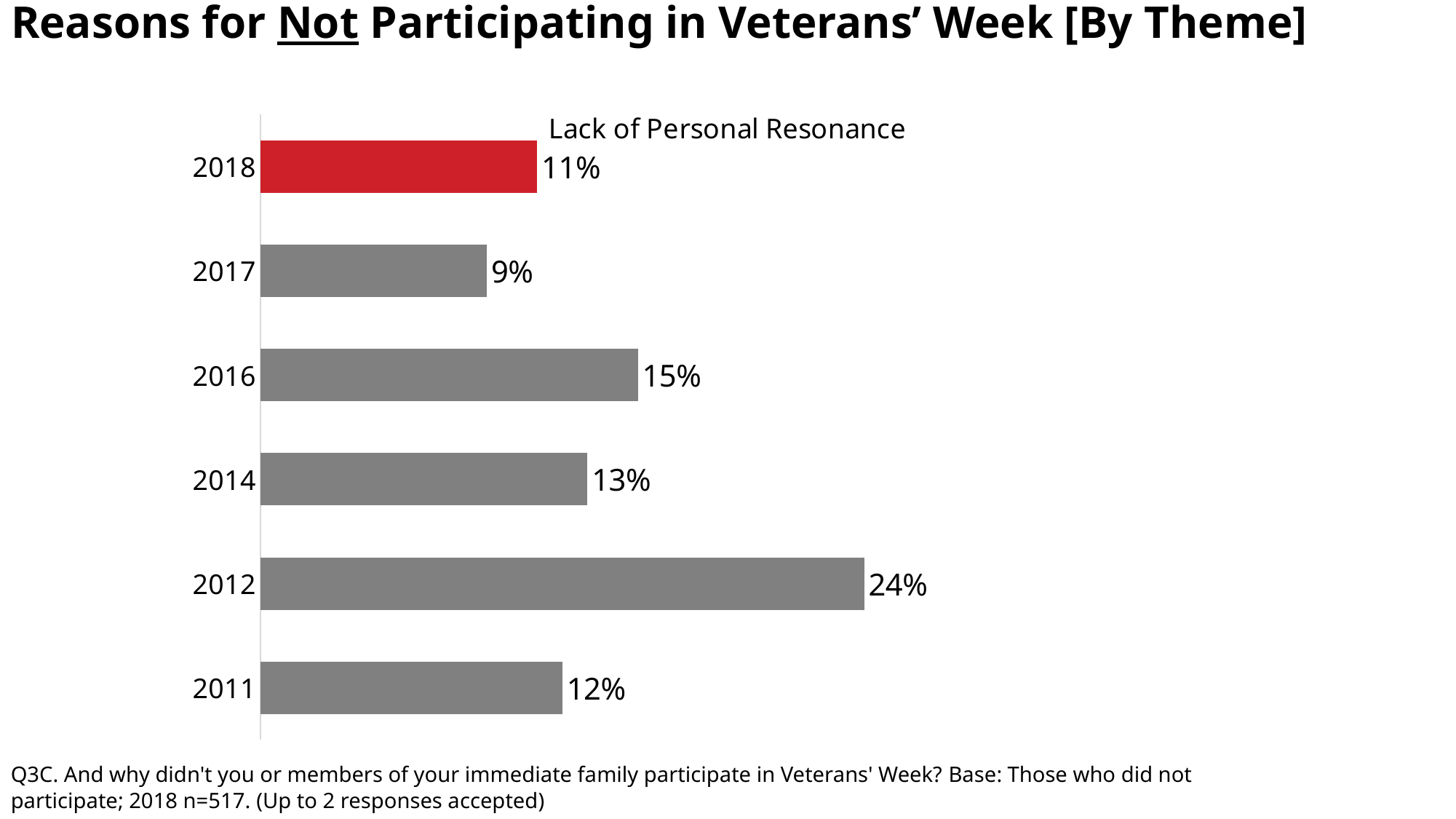
How many years are shown in the chart? 6 What is the difference between the 2016 value and the 2014 value? 2% Which year's bar is highlighted in red? 2018 Which is larger, the value for 2016 or the value for 2011? 2016 What kind of chart is shown on the slide? Bar chart What percentage is shown for 2018 in the Lack of Personal Resonance chart? 11% What is the difference between the 2012 value and the 2018 value? 13% Which year has the highest value? 2012 Which year has the lowest value? 2017 What value is shown for 2012? 24% What value is shown for 2017? 9% What theme label is shown above the bars? Lack of Personal Resonance